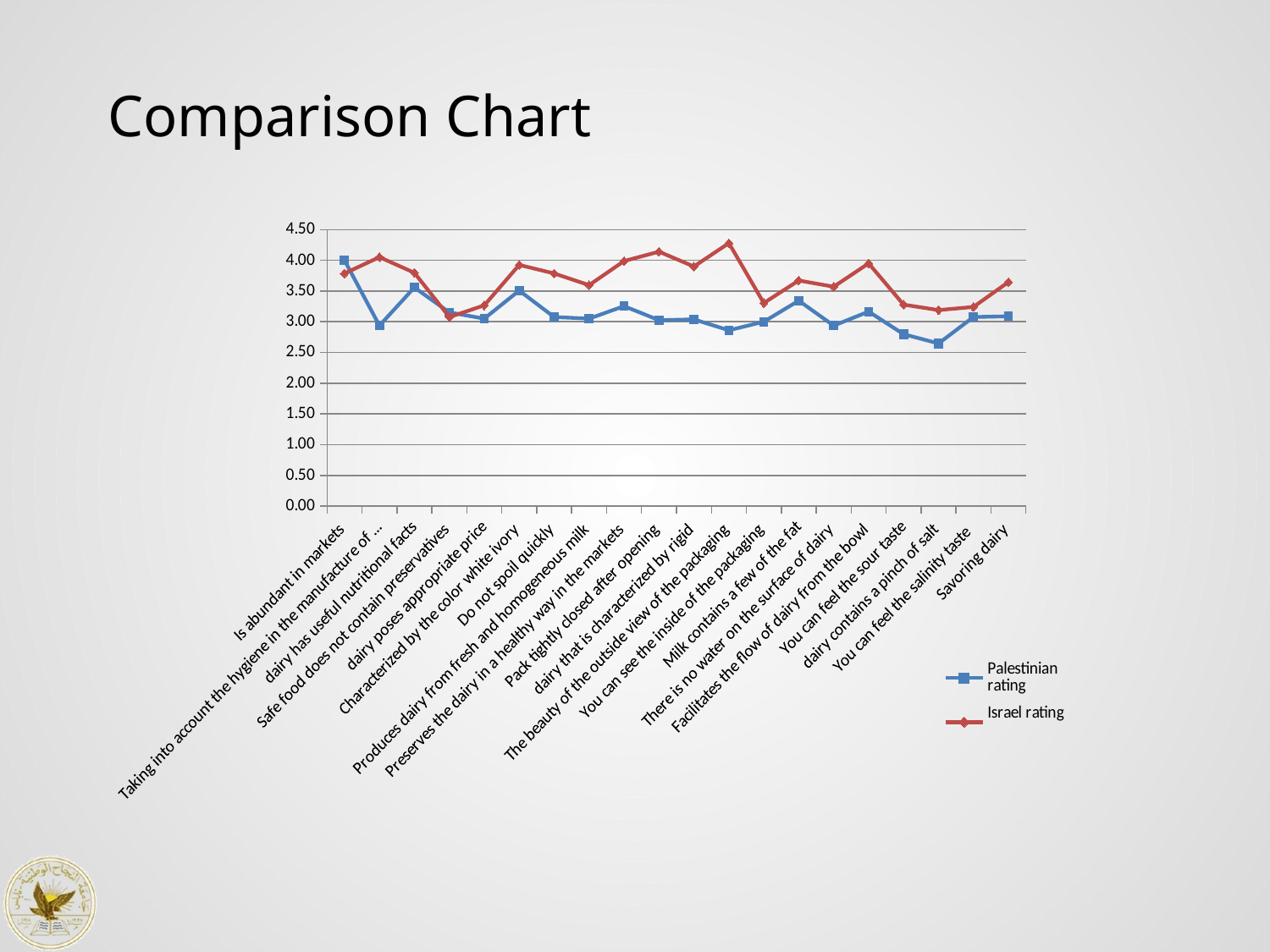
For which category is the Palestinian rating highest? Is abundant in markets What kind of chart is shown on the slide? Line chart For which category is the Israel rating highest? The beauty of the outside view of the packaging How many series does the legend list? 2 How many categories are plotted along the x axis? 20 For which category is the Palestinian rating lowest? dairy contains a pinch of salt For 'You can see the inside of the packaging', which is higher: the Palestinian rating or the Israel rating? Israel rating What is the title of the slide's chart? Comparison Chart Is the Palestinian rating for 'dairy contains a pinch of salt' greater or less than 3.00? less Which series is drawn in red? Israel rating For 'Is abundant in markets', which is higher: the Palestinian rating or the Israel rating? Palestinian rating Is the Israel rating for 'You can see the inside of the packaging' greater or less than 4.00? less